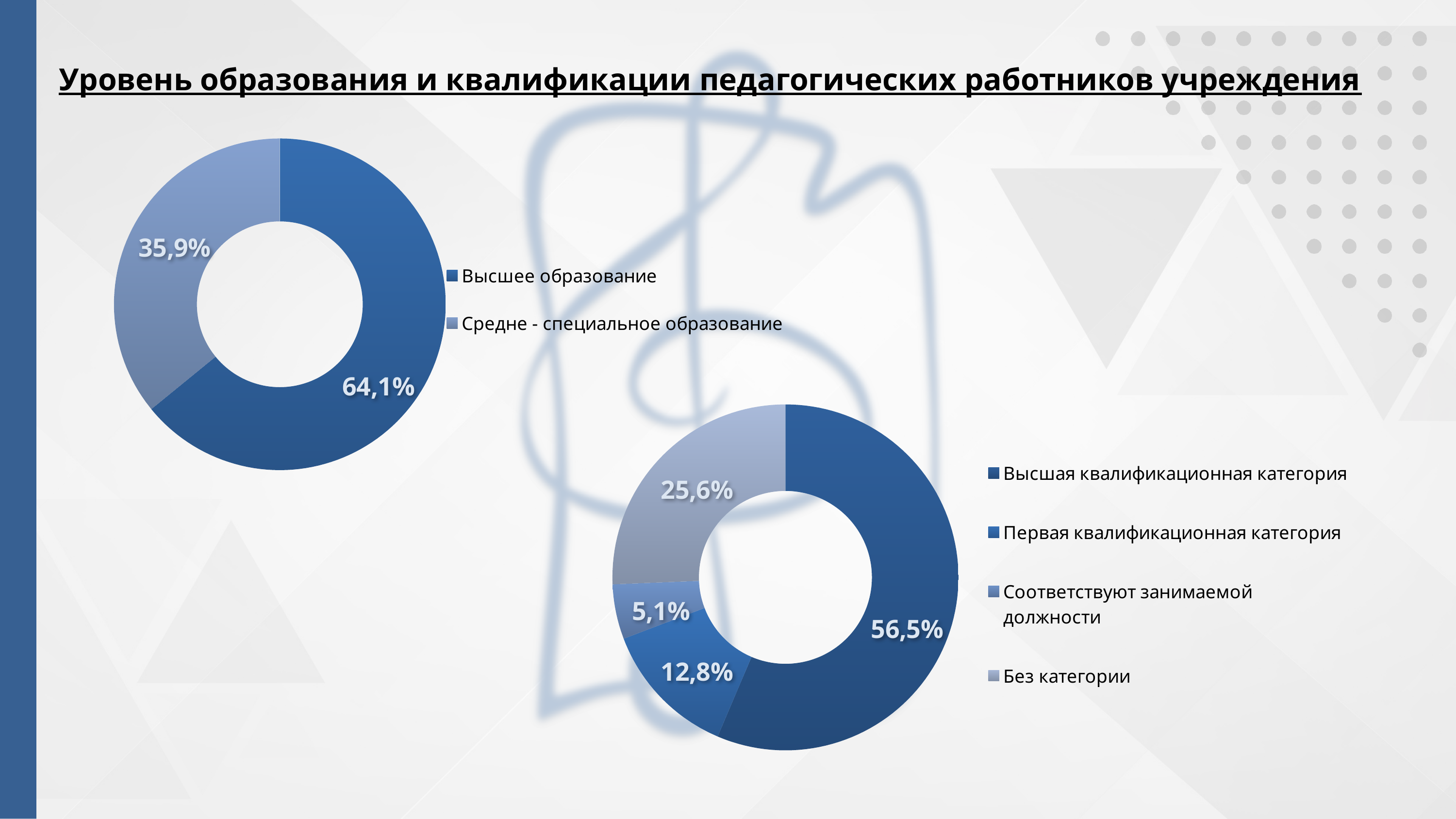
In the lower-right chart, which is larger: the share for Без категории or the share for Первая квалификационная категория? Без категории In the lower-right chart, what share is labelled for Без категории? 25,6% In the upper-left chart, which category has the larger share? Высшее образование What type of chart is the lower-right chart? Doughnut (pie) chart In the upper-left chart, what is the difference between the shares for Высшее образование and Средне - специальное образование? 28,2% In the lower-right chart, which category has the smallest share? Соответствуют занимаемой должности In the upper-left chart, what share is labelled for Высшее образование? 64,1% In the upper-left chart, what share is labelled for Средне - специальное образование? 35,9% How many categories does the legend of the upper-left chart list? 2 In the lower-right chart, what share is labelled for Первая квалификационная категория? 12,8% In the lower-right chart, what share is labelled for Высшая квалификационная категория? 56,5% How many categories does the legend of the lower-right chart list? 4